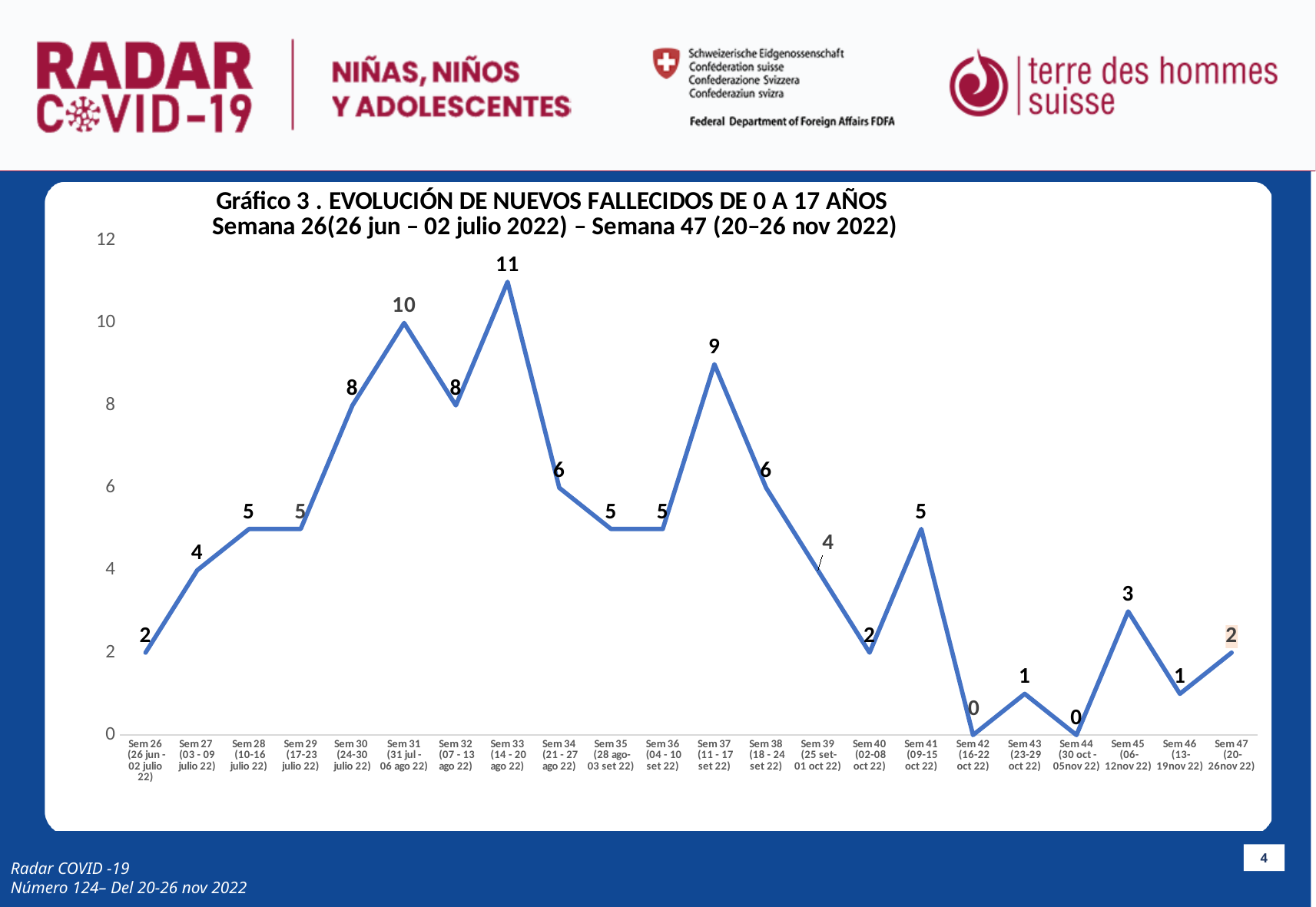
What is the difference between the values for Sem 33 and Sem 34? 5 How many weeks are plotted on the x axis? 22 What is the title of the chart? Gráfico 3 . EVOLUCIÓN DE NUEVOS FALLECIDOS DE 0 A 17 AÑOS Semana 26(26 jun – 02 julio 2022) – Semana 47 (20–26 nov 2022) What is the value for Sem 31 (31 jul - 06 ago 22)? 10 What is the value for Sem 33 (14 - 20 ago 22)? 11 Which week has the highest value? Sem 33 (14 - 20 ago 22) Which weeks have a value of 0? Sem 42 and Sem 44 Which is larger, the value for Sem 41 (09-15 oct 22) or the value for Sem 45 (06-12 nov 22)? Sem 41 (09-15 oct 22) What is the value for Sem 37 (11 - 17 set 22)? 9 Does the line rise or fall from Sem 26 to Sem 31? rise What is the value for Sem 47 (20-26 nov 22)? 2 What type of chart is shown on the slide? line chart